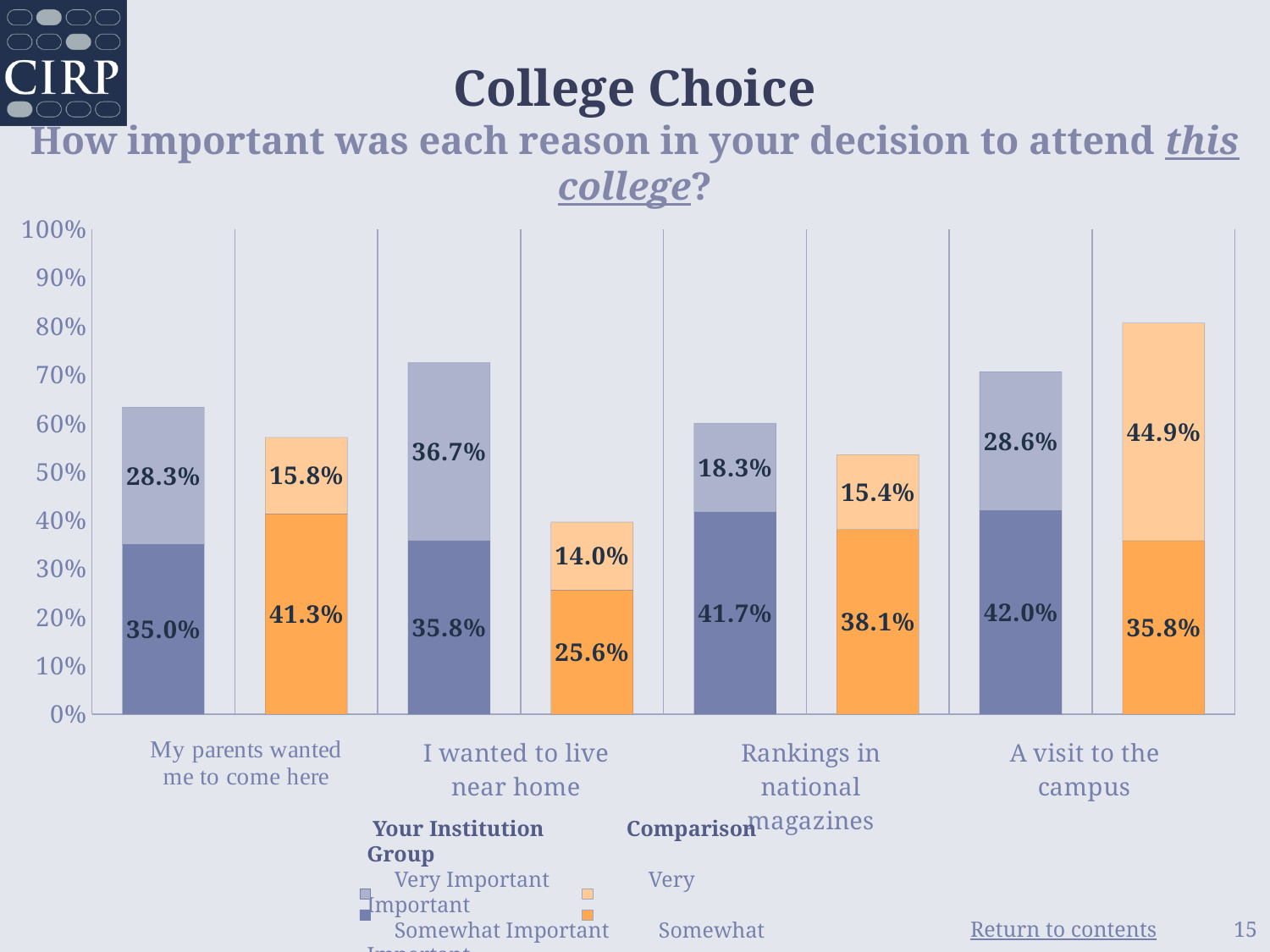
Which reason has the highest Comparison Group 'Very Important' percentage? A visit to the campus What percentage of Your Institution students rated 'A visit to the campus' as Very Important? 28.6% What percentage of the Comparison Group rated 'I wanted to live near home' as Somewhat Important? 25.6% What percentage of Your Institution students rated 'Rankings in national magazines' as Somewhat Important? 41.7% How many reasons (categories) are shown on the x axis? 4 What is the total height of the Comparison Group stacked bar for 'A visit to the campus'? 80.7% What is the total height of the Your Institution stacked bar for 'I wanted to live near home'? 72.5% For 'My parents wanted me to come here', which group has the larger 'Somewhat Important' percentage, Your Institution or the Comparison Group? Comparison Group What kind of chart is shown on the slide? Stacked bar chart How many series does the legend list? 4 Which reason has the lowest Comparison Group 'Very Important' percentage? I wanted to live near home What is the difference between the Your Institution and Comparison Group 'Very Important' percentages for 'I wanted to live near home'? 22.7%